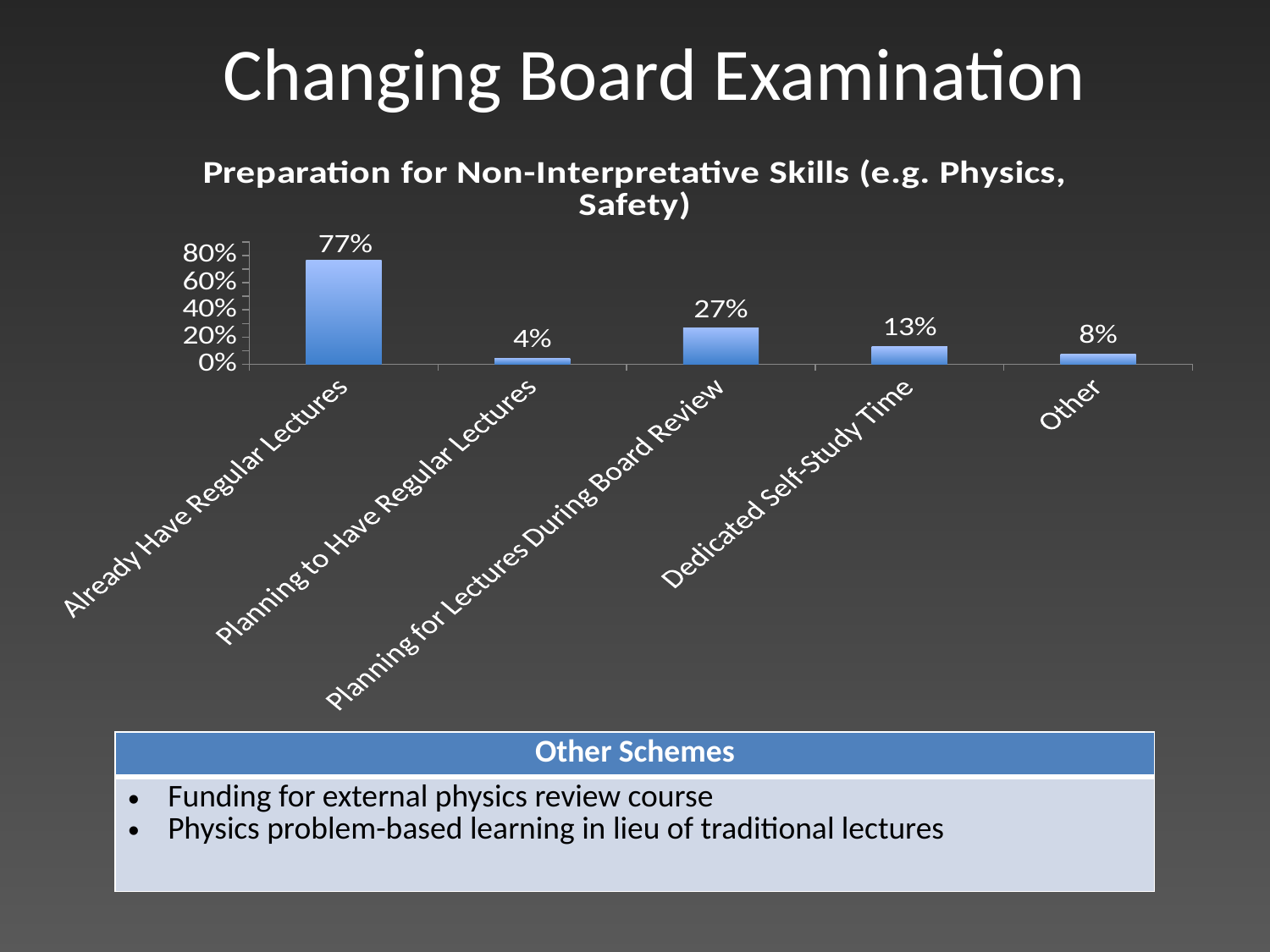
What is the value for Dedicated Self-Study Time? 13% What is the value for Planning to Have Regular Lectures? 4% What is the value for Planning for Lectures During Board Review? 27% What kind of chart is shown on the slide? Bar chart What is the title of the chart? Preparation for Non-Interpretative Skills (e.g. Physics, Safety) Which category has the lowest value? Planning to Have Regular Lectures What is the value for Already Have Regular Lectures? 77% Which category has the highest value? Already Have Regular Lectures What is the value for Other? 8% What is the difference between Already Have Regular Lectures and Planning for Lectures During Board Review? 50% How many categories are shown in the chart? 5 Which is larger, Dedicated Self-Study Time or Other? Dedicated Self-Study Time